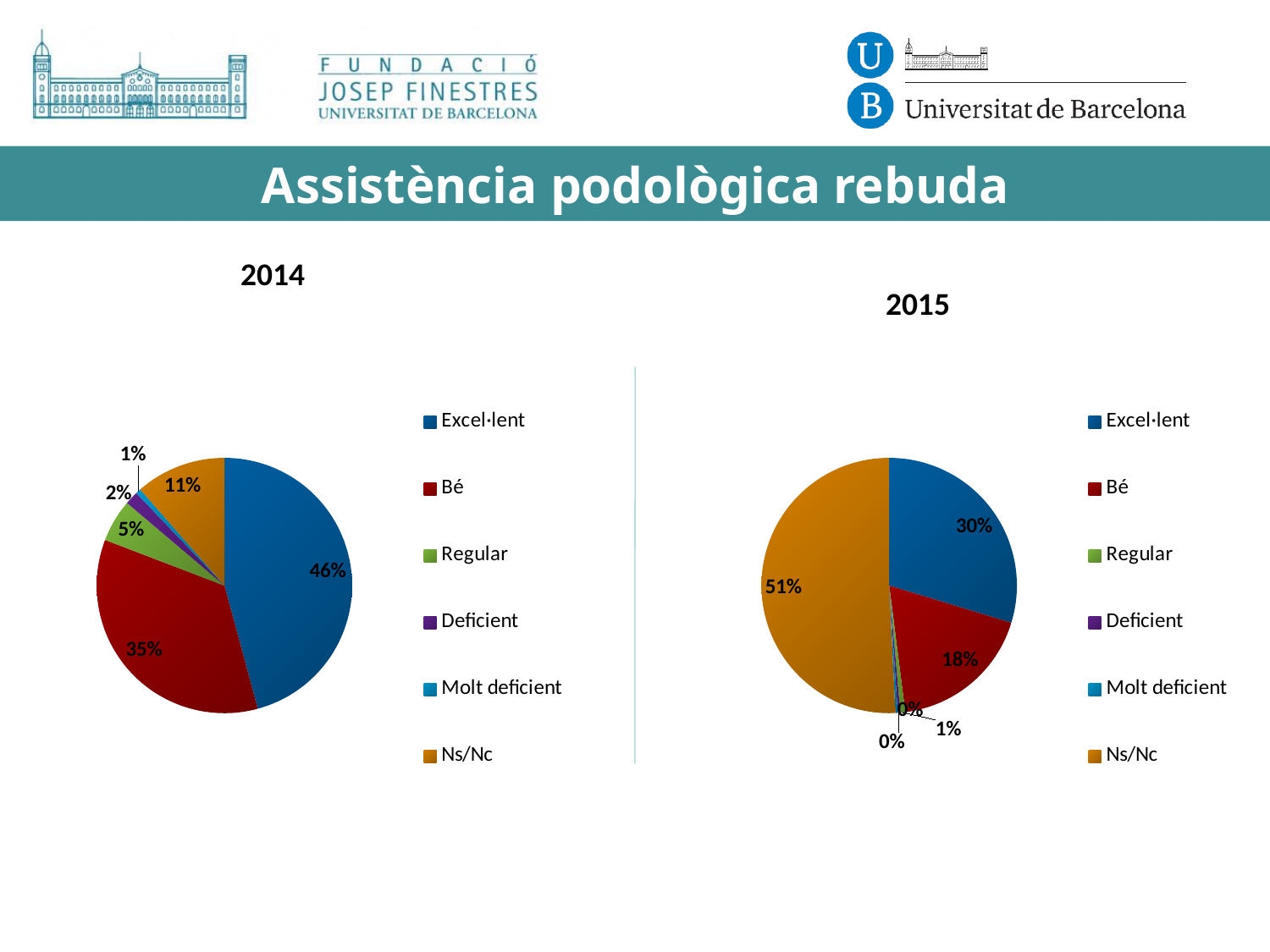
In the 2015 chart, what share of the pie is Bé? 18% In the 2014 chart, what is the difference between the Excel·lent and Bé shares? 11% In the 2014 chart, what share of the pie is Ns/Nc? 11% How many categories does the legend of the 2014 chart list? 6 In the 2015 chart, which category has the largest slice? Ns/Nc What type of chart is used for the 2015 data? Pie chart In the 2015 chart, what share of the pie is Excel·lent? 30% In the 2015 chart, what share of the pie is Ns/Nc? 51% In the 2014 chart, what share of the pie is Bé? 35% In the 2014 chart, which category has the largest slice? Excel·lent In the 2014 chart, what share of the pie is Excel·lent? 46% In the 2014 chart, which category has the smallest slice? Molt deficient